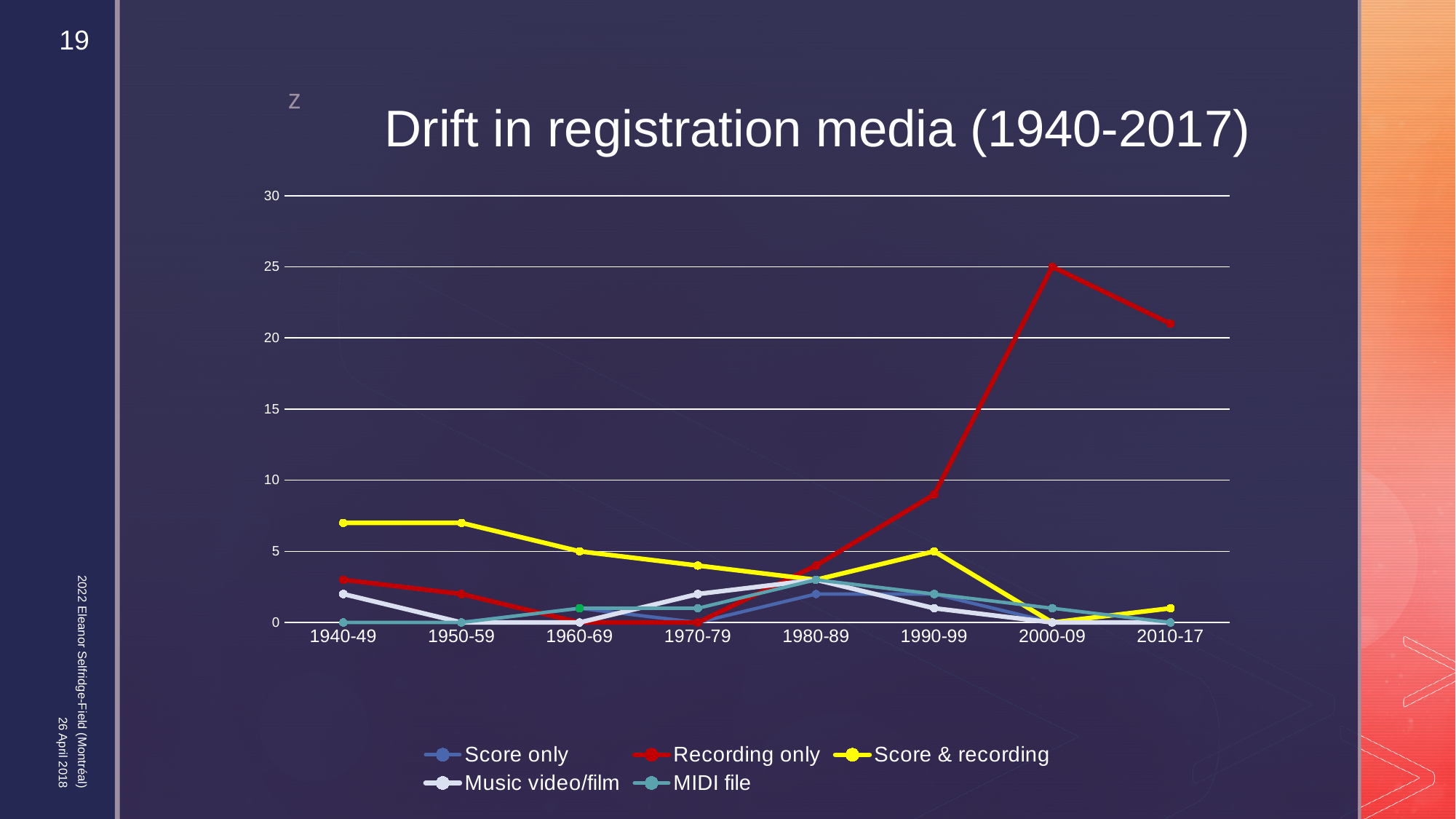
How many series does the legend list? 5 What is the value for Score & recording in 2000-09? 0 What is the title of the chart? Drift in registration media (1940-2017) How many time periods are shown on the x axis? 8 What kind of chart is shown on the slide? line chart In 1940-49, which is larger: Score & recording or Recording only? Score & recording Is the value for Recording only in 2010-17 greater or less than 25? less Which series reaches the highest value anywhere on the chart? Recording only In which period does Recording only reach its highest value? 2000-09 Does the Recording only line rise or fall from 1970-79 to 2000-09? rise Is the value for Score & recording in 1940-49 greater or less than 5? greater What is the value for Recording only in 2000-09? 25